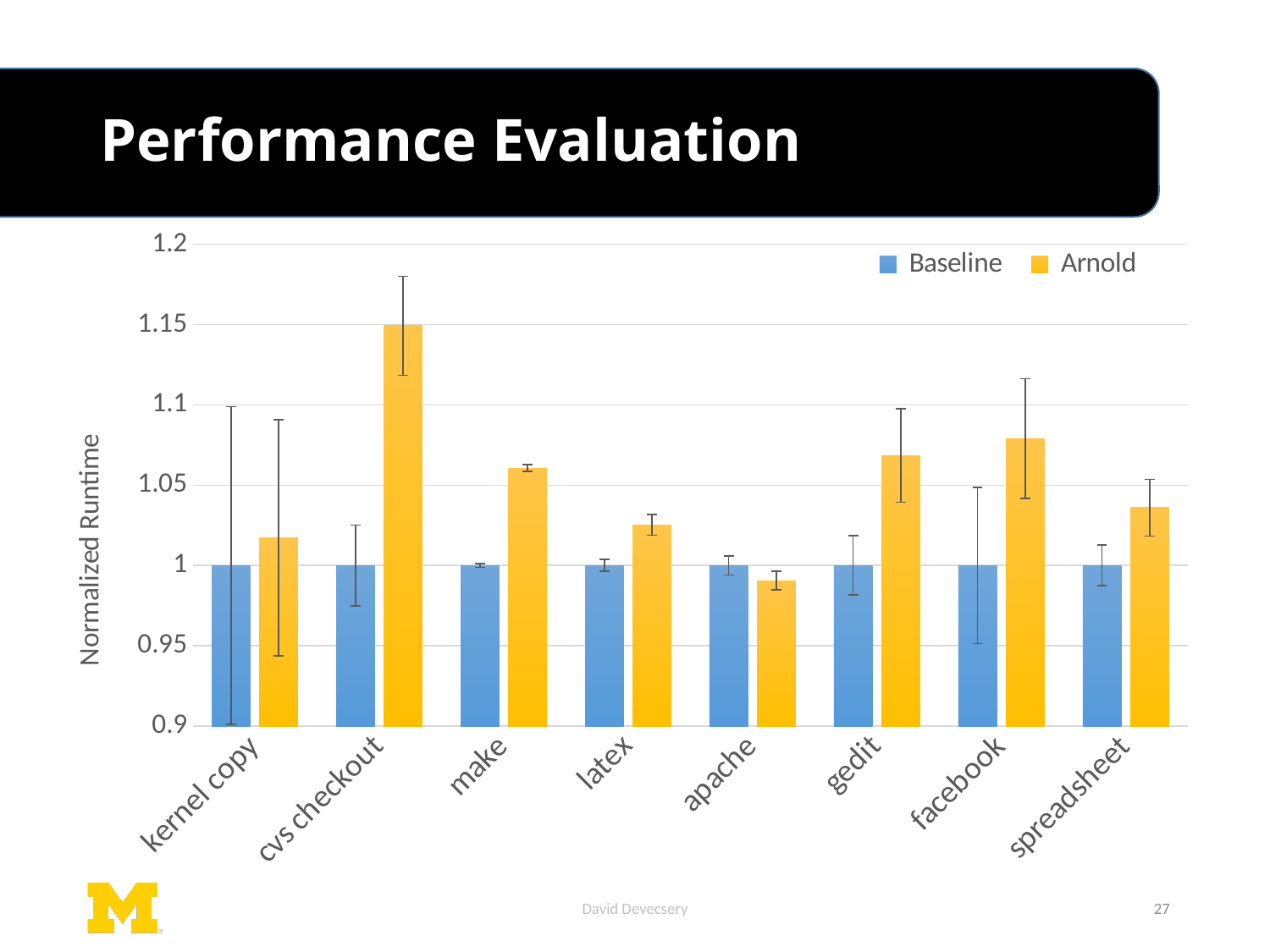
How many series does the legend list? 2 What is the Baseline value for apache? 1 What kind of chart is shown on the slide? bar chart Which is larger, the Arnold value for facebook or the Arnold value for spreadsheet? facebook Which category has the lowest Arnold value? apache What is the Baseline value for make? 1 Which category has the highest Arnold value? cvs checkout Is the Arnold value for gedit greater or less than 1.05? greater Is the Arnold value for cvs checkout greater or less than 1.1? greater Is the Arnold value for apache greater or less than 1? less What is the label of the y axis? Normalized Runtime How many categories are shown along the x axis? 8